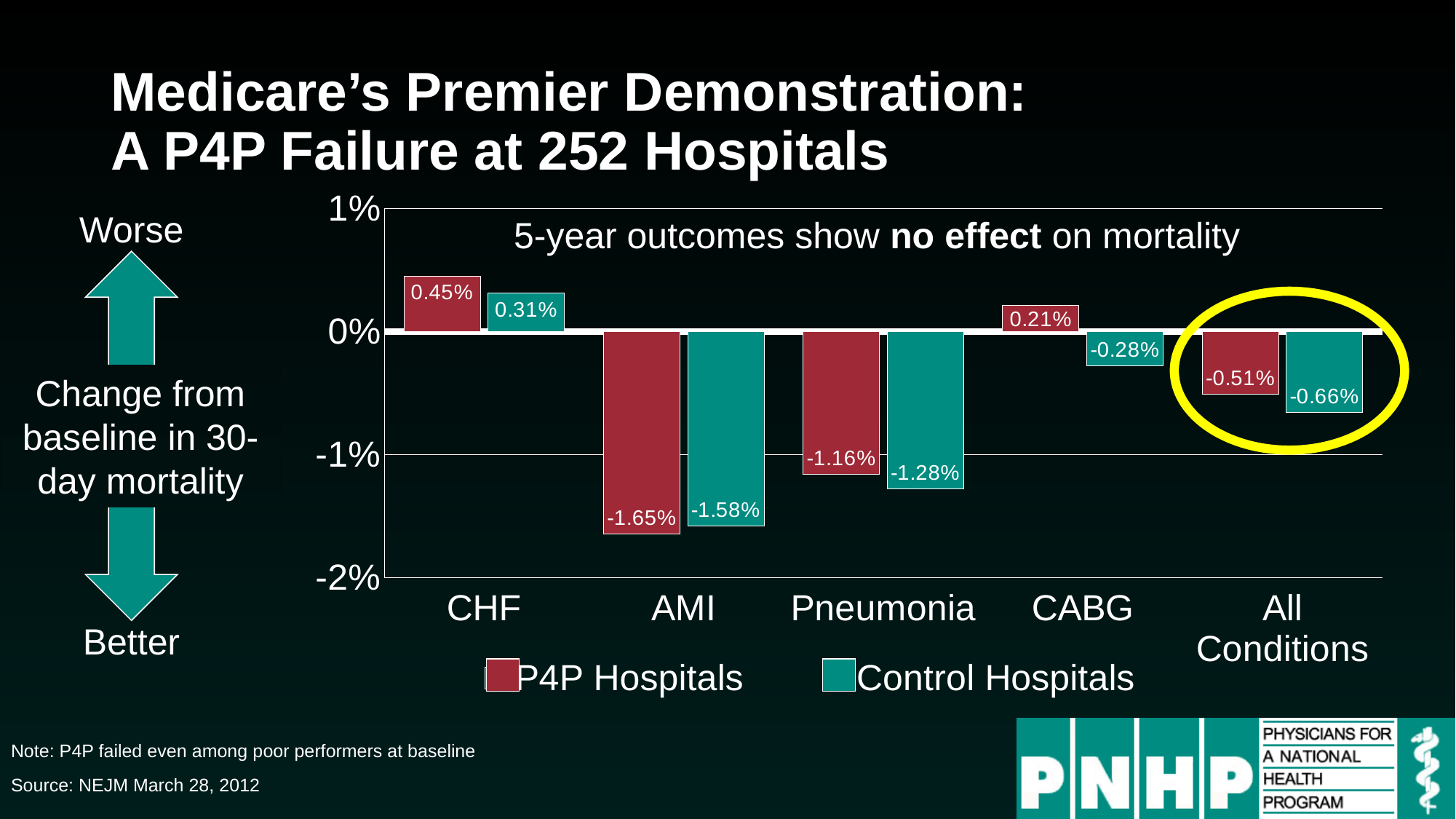
What is the value for Control Hospitals for All Conditions? -0.66% What is the value for Control Hospitals for AMI? -1.58% Which category is circled in yellow on the chart? All Conditions What is the value for P4P Hospitals for CABG? 0.21% Which category has the lowest value for P4P Hospitals? AMI How many series does the legend list? 2 What is the difference between the P4P Hospitals and Control Hospitals values for Pneumonia? 0.12% Which category has the highest value for Control Hospitals? CHF What kind of chart is shown on the slide? Bar chart For CABG, which series has the larger value, P4P Hospitals or Control Hospitals? P4P Hospitals How many categories are shown on the x axis? 5 What is the value for P4P Hospitals for CHF? 0.45%